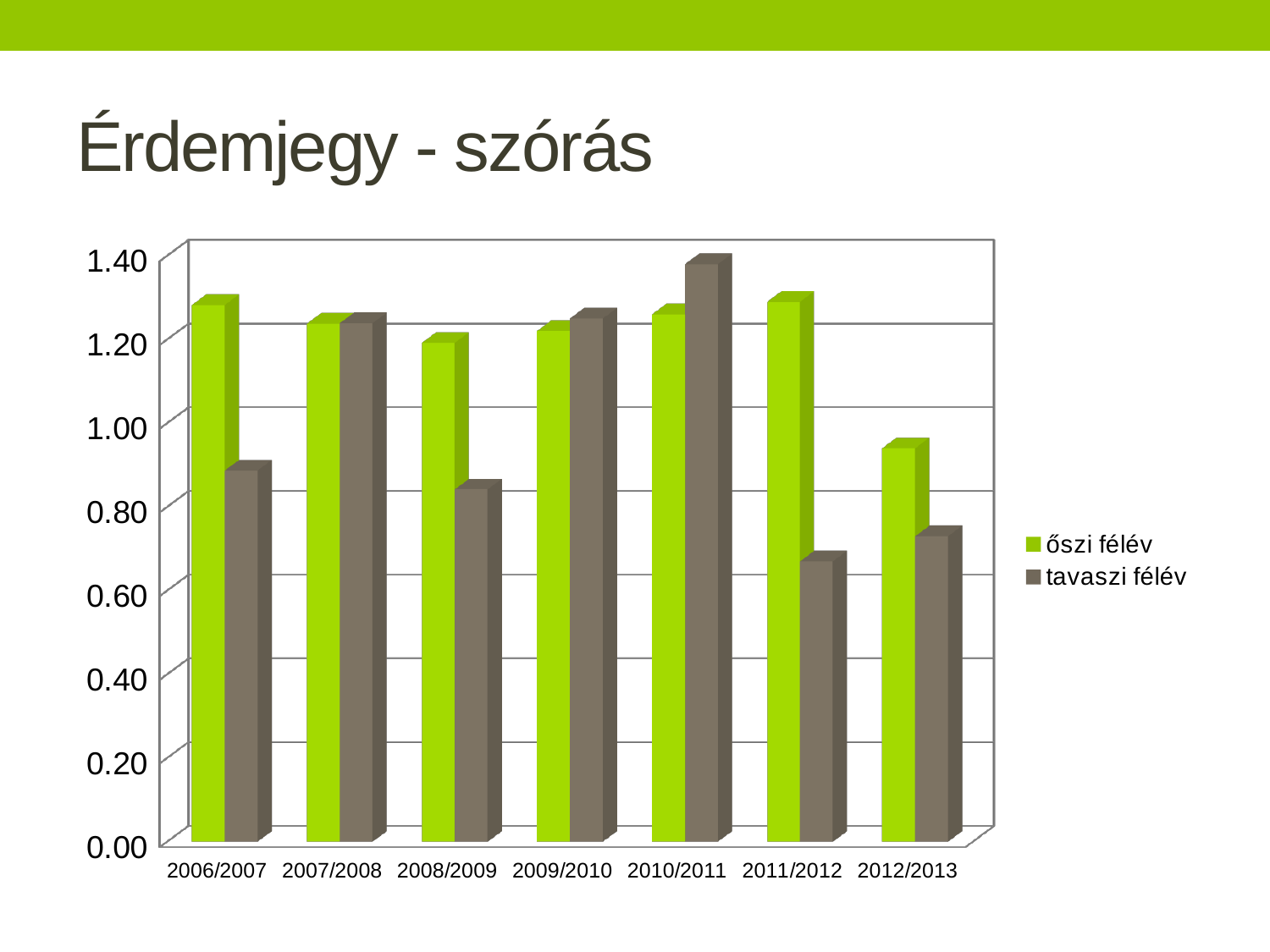
What kind of chart is shown on the slide? bar chart How many academic years are shown on the x axis of the chart? 7 What is the title of the slide containing the chart? Érdemjegy - szórás Is the tavaszi félév value for 2010/2011 greater or less than 1.20? greater For which academic year is the tavaszi félév value lowest? 2011/2012 In 2010/2011, which series has the larger value, őszi félév or tavaszi félév? tavaszi félév For which academic year is the tavaszi félév value highest? 2010/2011 How many series does the chart's legend list? 2 Is the tavaszi félév value for 2006/2007 greater or less than 1.00? less For which academic year is the őszi félév value lowest? 2012/2013 Is the őszi félév value for 2012/2013 greater or less than 1.00? less Which series has the lowest value in 2011/2012? tavaszi félév